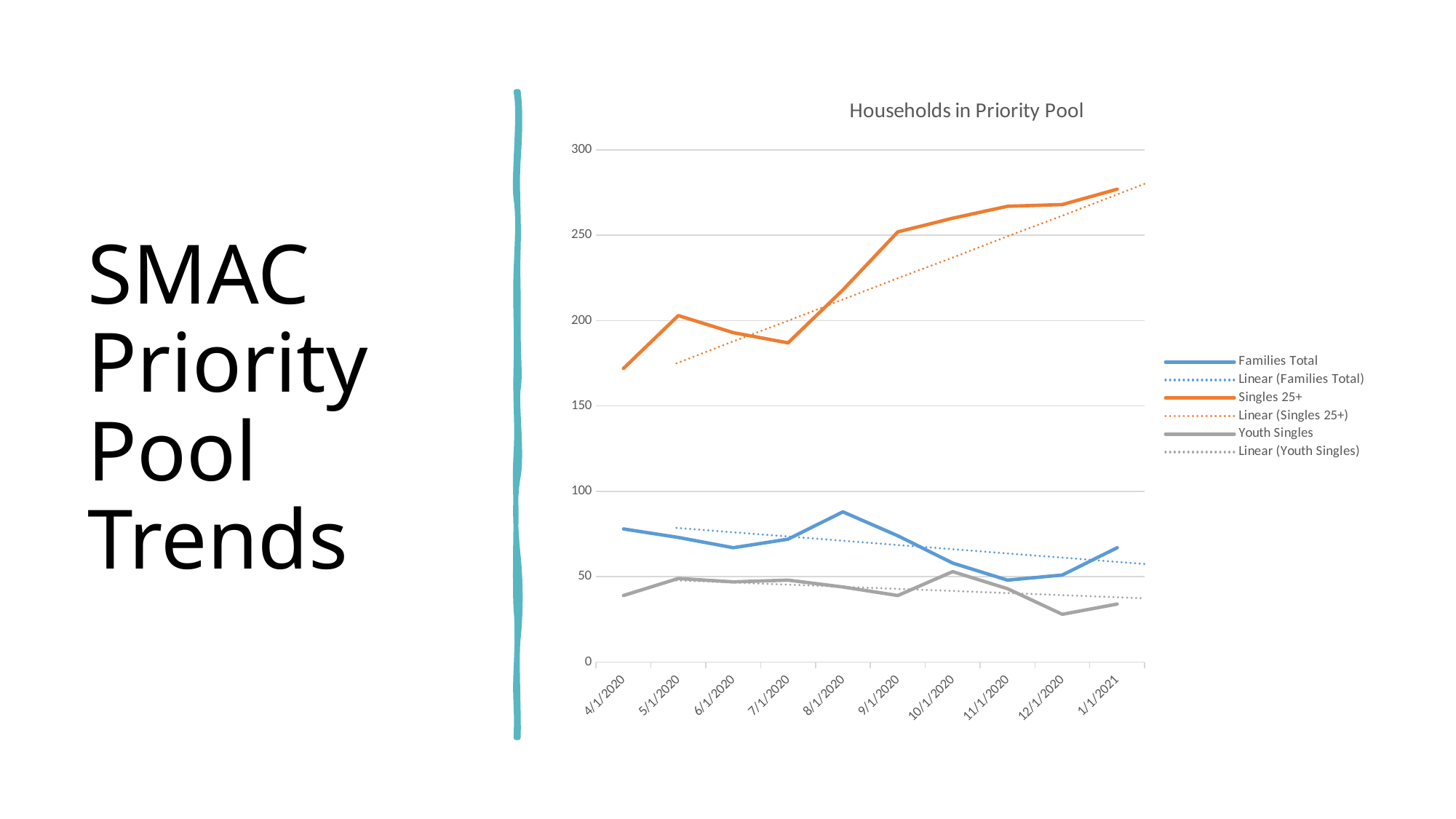
How many dates are plotted along the x axis? 10 At which date does the Families Total series reach its highest value? 8/1/2020 At which date does the Singles 25+ series reach its highest value? 1/1/2021 Does the Singles 25+ series generally rise or fall from 4/1/2020 to 1/1/2021? rise Is the value for Singles 25+ at 1/1/2021 greater or less than 250? greater How many entries does the chart legend list? 6 At which date is the Youth Singles series at its lowest value? 12/1/2020 At which date is the Singles 25+ series at its lowest value? 4/1/2020 What kind of chart is shown on the slide? line chart Which series has the highest values throughout the chart? Singles 25+ Is the value for Families Total at 8/1/2020 greater or less than 100? less What is the title of the chart? Households in Priority Pool